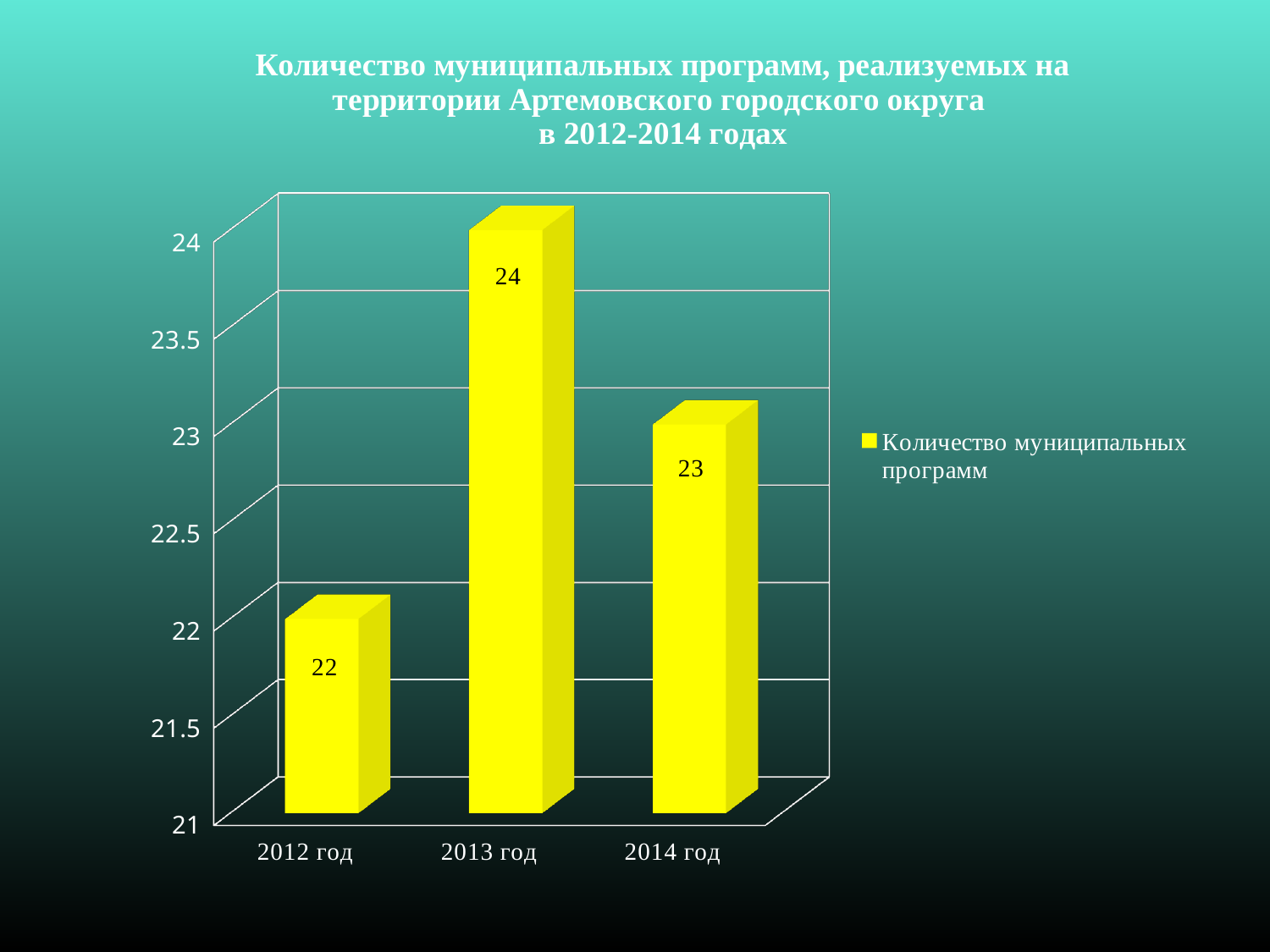
Which is larger, the value for 2014 год or the value for 2012 год? 2014 год How many series does the legend list? 1 Is the value for 2014 год greater or less than 22.5? greater Which year has the highest number of municipal programs? 2013 год How many categories are shown on the x axis? 3 Which year has the lowest number of municipal programs? 2012 год What is the value for 2014 год? 23 What is the value for 2012 год? 22 What is the difference between the values for 2013 год and 2014 год? 1 What is the difference between the values for 2013 год and 2012 год? 2 What is the value for 2013 год? 24 What kind of chart is shown on the slide? bar chart